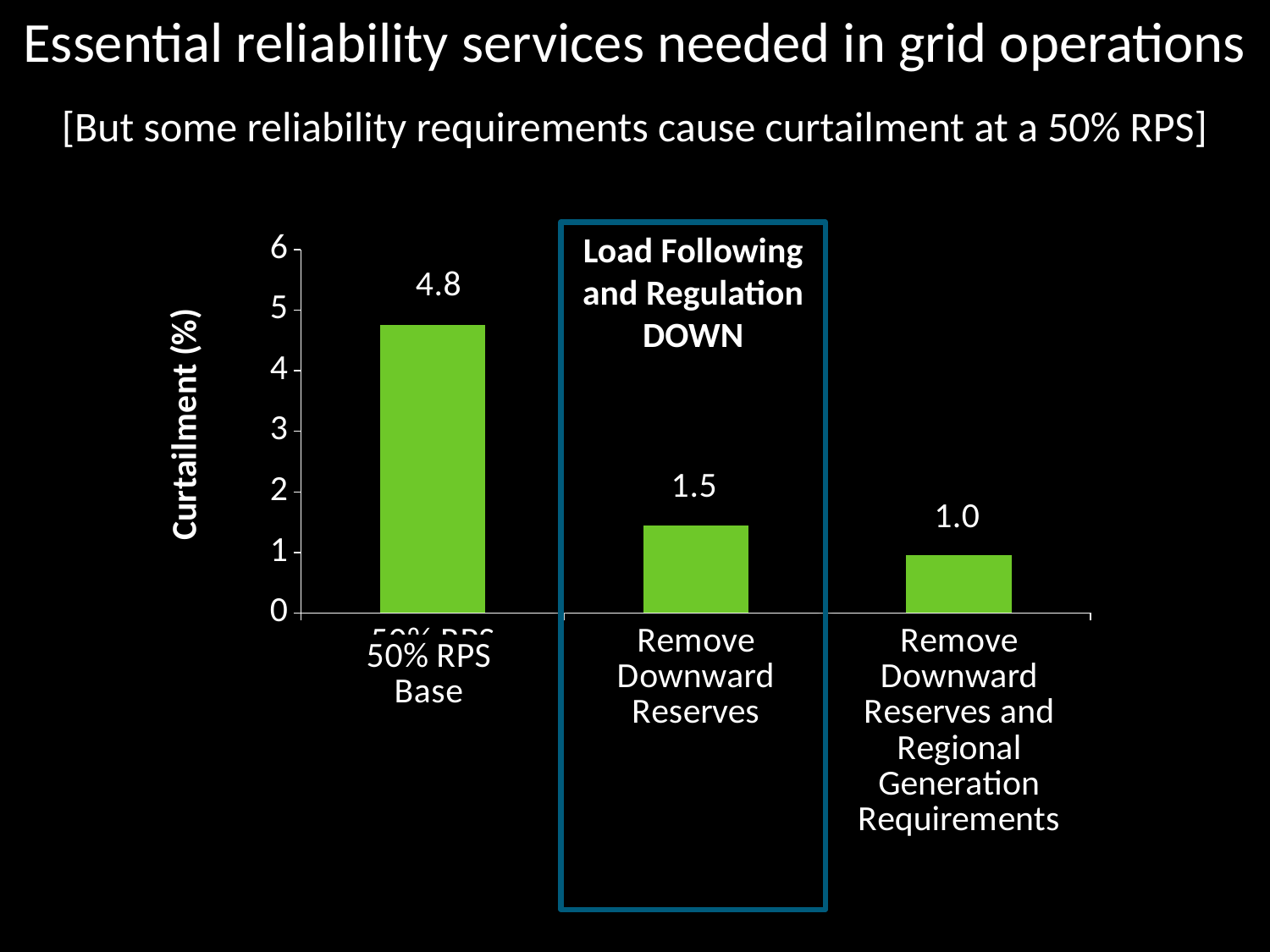
What is the label of the vertical axis? Curtailment (%) What is the curtailment value for the 50% RPS Base category? 4.8 What is the difference in curtailment between Remove Downward Reserves and Remove Downward Reserves and Regional Generation Requirements? 0.5 Which category has the highest curtailment? 50% RPS Base What kind of chart is shown on the slide? Bar chart Which category has the lowest curtailment? Remove Downward Reserves and Regional Generation Requirements What is the curtailment value for the Remove Downward Reserves category? 1.5 Is the curtailment value for 50% RPS Base greater or less than 4? greater How many categories are shown on the chart? 3 Which has a larger curtailment value: 50% RPS Base or Remove Downward Reserves? 50% RPS Base What is the curtailment value for the Remove Downward Reserves and Regional Generation Requirements category? 1.0 What is the difference in curtailment between 50% RPS Base and Remove Downward Reserves? 3.3